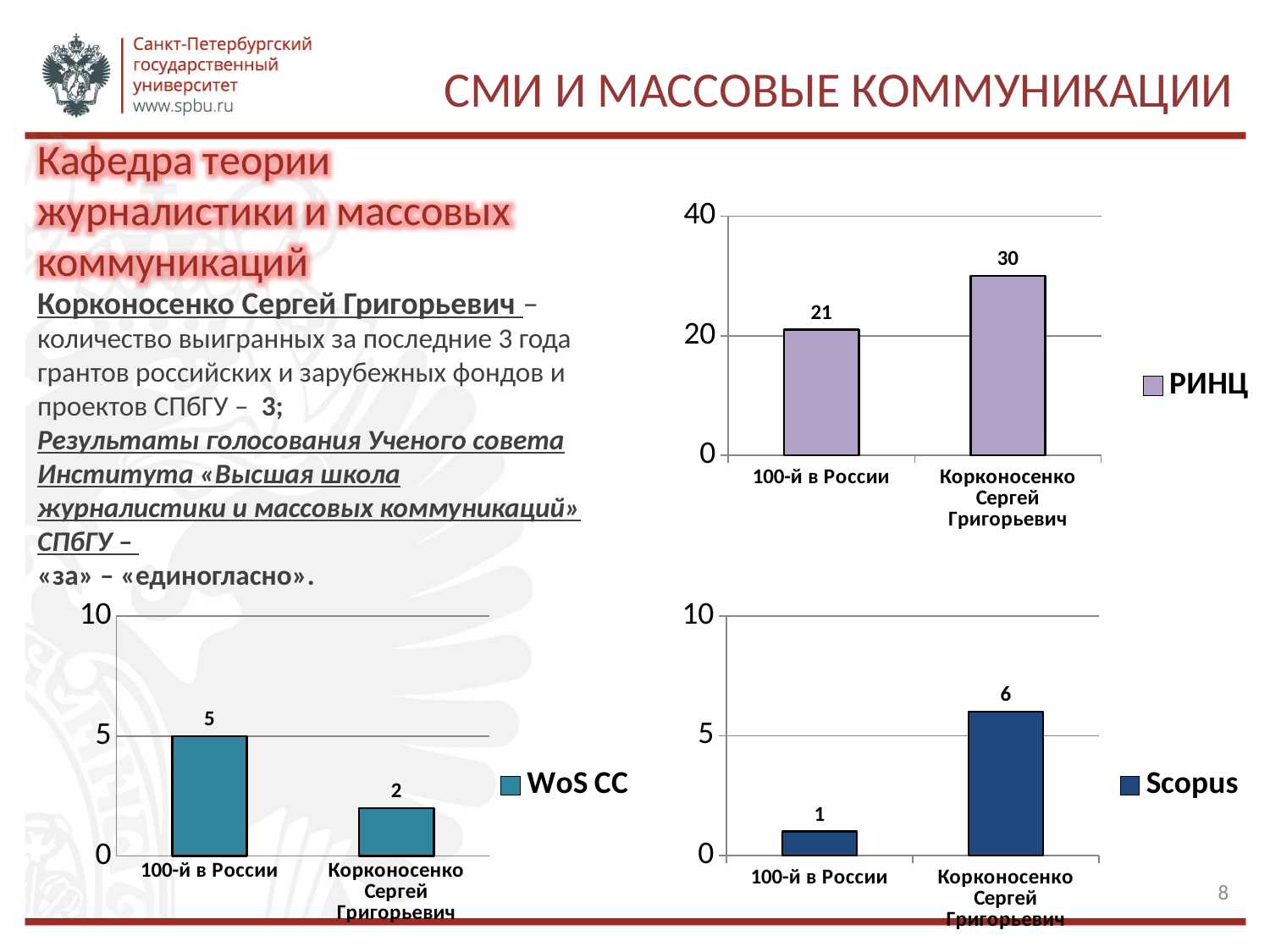
In the WoS CC chart, what is the value for 100-й в России? 5 In the Scopus chart, what is the difference between the values for Корконосенко Сергей Григорьевич and 100-й в России? 5 In the РИНЦ chart, what is the value for Корконосенко Сергей Григорьевич? 30 In the РИНЦ chart, is the value for Корконосенко Сергей Григорьевич greater or less than 20? greater In the WoS CC chart, which is larger: the value for 100-й в России or for Корконосенко Сергей Григорьевич? 100-й в России In the РИНЦ chart, what is the difference between the values for Корконосенко Сергей Григорьевич and 100-й в России? 9 In the РИНЦ chart, what is the value for 100-й в России? 21 In the Scopus chart, what is the value for Корконосенко Сергей Григорьевич? 6 What kind of chart is the WoS CC chart? bar chart In the WoS CC chart, which category has the lowest value? Корконосенко Сергей Григорьевич In the Scopus chart, which category has the highest value? Корконосенко Сергей Григорьевич How many categories are shown in the Scopus chart? 2